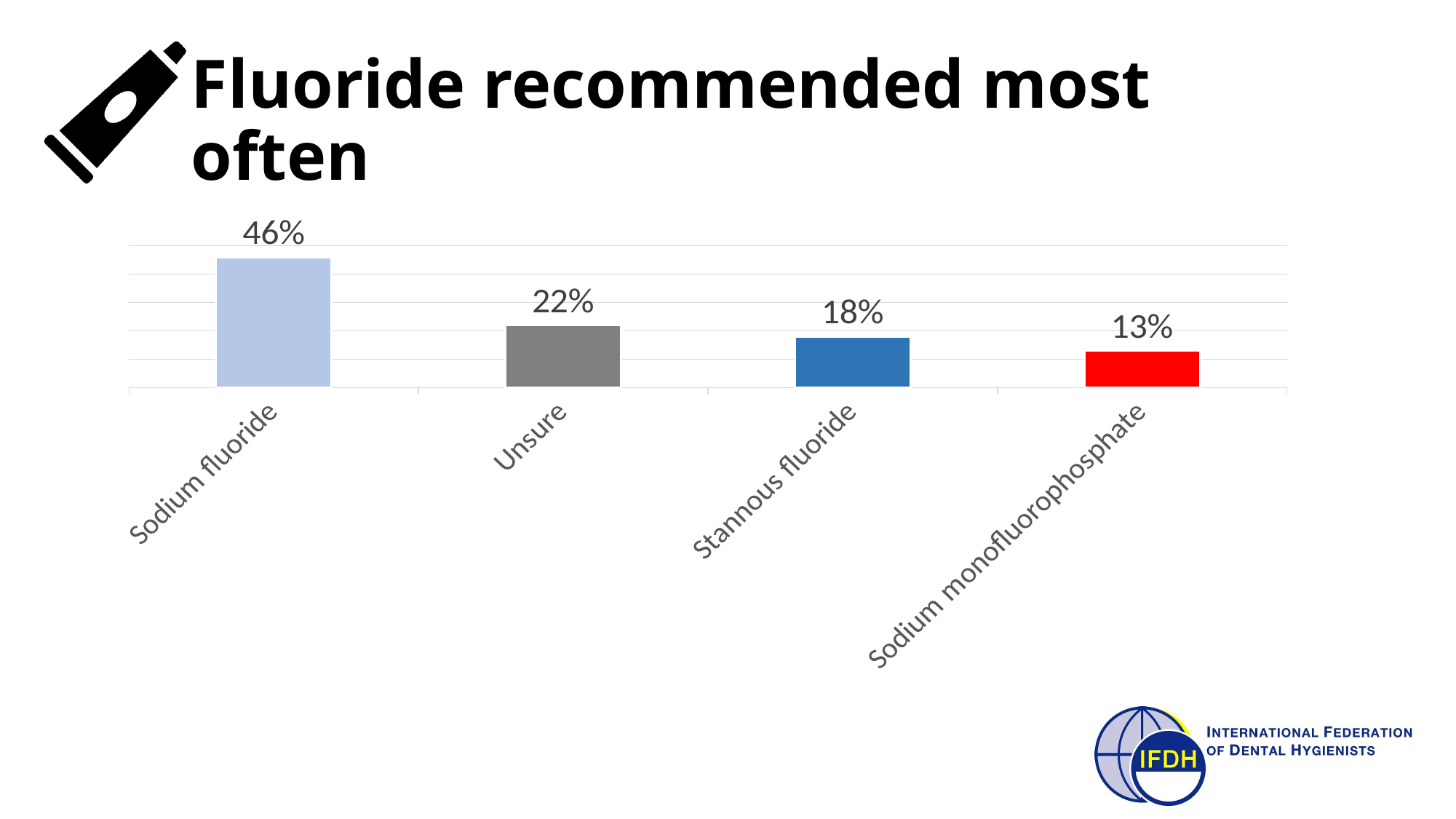
What percentage is shown for Unsure? 22% What is the difference between the values for Sodium fluoride and Unsure? 24% What kind of chart is shown on the slide? Bar chart What percentage is shown for Sodium fluoride? 46% Which is larger, the value for Unsure or the value for Stannous fluoride? Unsure What is the difference between the values for Stannous fluoride and Sodium monofluorophosphate? 5% Which category has the highest value? Sodium fluoride What percentage is shown for Stannous fluoride? 18% Which category has the lowest value? Sodium monofluorophosphate How many categories are shown in the chart? 4 What percentage is shown for Sodium monofluorophosphate? 13% What is the title of the slide? Fluoride recommended most often